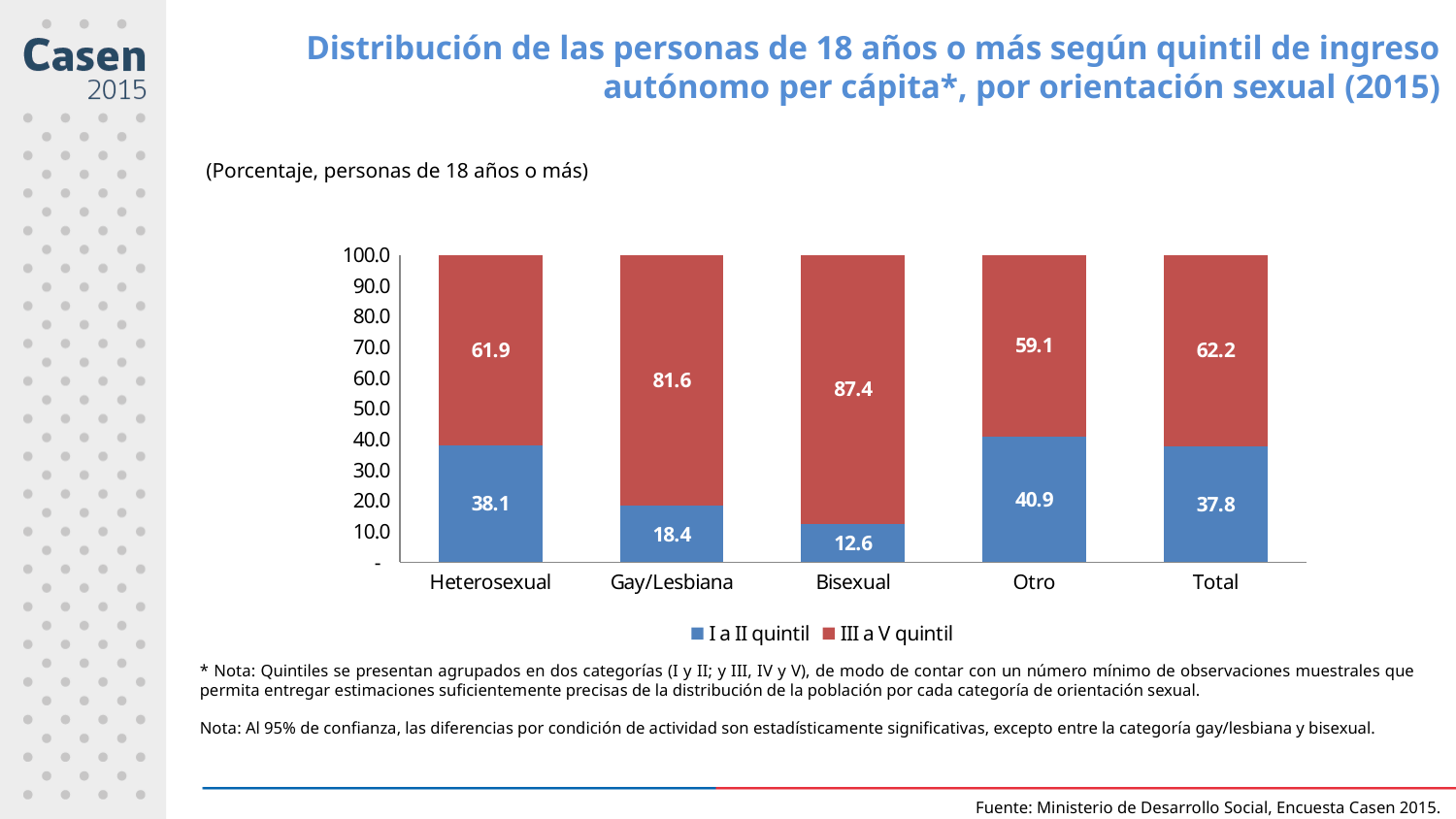
What is the difference between the 'I a II quintil' values for Otro and Gay/Lesbiana? 22.5 Which category has the highest value for 'I a II quintil'? Otro Which is larger, the 'I a II quintil' value for Heterosexual or for Total? Heterosexual How many series does the legend list? 2 What is the value of the 'I a II quintil' series for Bisexual? 12.6 What is the value of the 'I a II quintil' series for Total? 37.8 What is the value of the 'III a V quintil' series for Gay/Lesbiana? 81.6 What kind of chart is shown on the slide? Stacked bar chart Which category has the lowest value for 'I a II quintil'? Bisexual How many categories are shown on the x axis? 5 What is the difference between the 'III a V quintil' values for Bisexual and Heterosexual? 25.5 Which category has the highest value for 'III a V quintil'? Bisexual